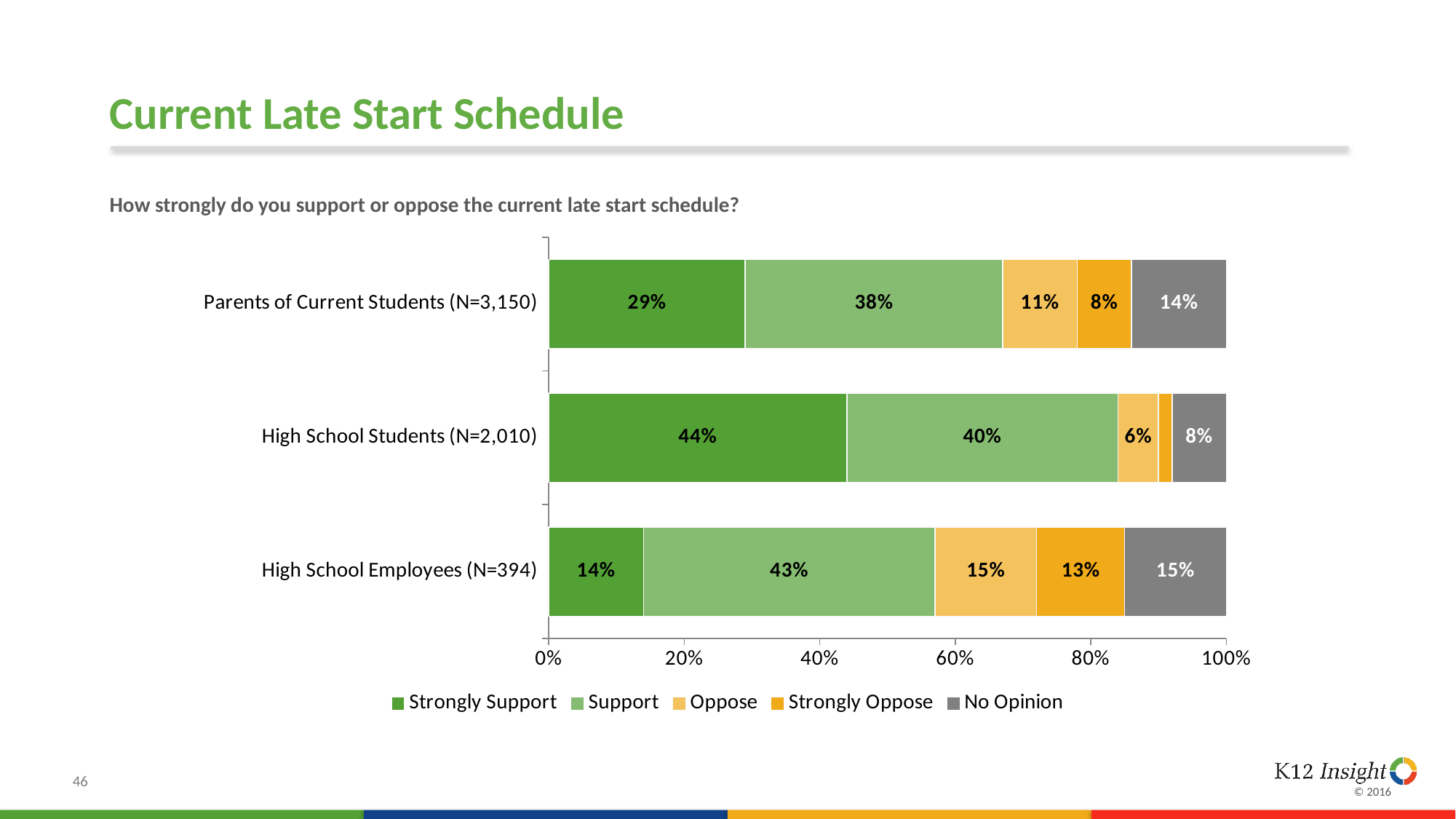
What kind of chart is shown on the slide? Stacked bar chart What percentage of High School Employees (N=394) chose Support? 43% What percentage of Parents of Current Students (N=3,150) Strongly Support the current late start schedule? 29% What percentage of High School Students (N=2,010) chose No Opinion? 8% What is the difference between the Strongly Support percentages for High School Students (N=2,010) and Parents of Current Students (N=3,150)? 15% Which group has the highest Strongly Support percentage? High School Students (N=2,010) Which group has the lowest Strongly Support percentage? High School Employees (N=394) How many respondent groups are shown on the chart? 3 Which is larger: the Oppose percentage for High School Employees (N=394) or for Parents of Current Students (N=3,150)? High School Employees (N=394) What percentage of High School Employees (N=394) Strongly Oppose the current late start schedule? 13% What is the total of the stacked bar for High School Employees (N=394)? 100% How many series does the legend list? 5